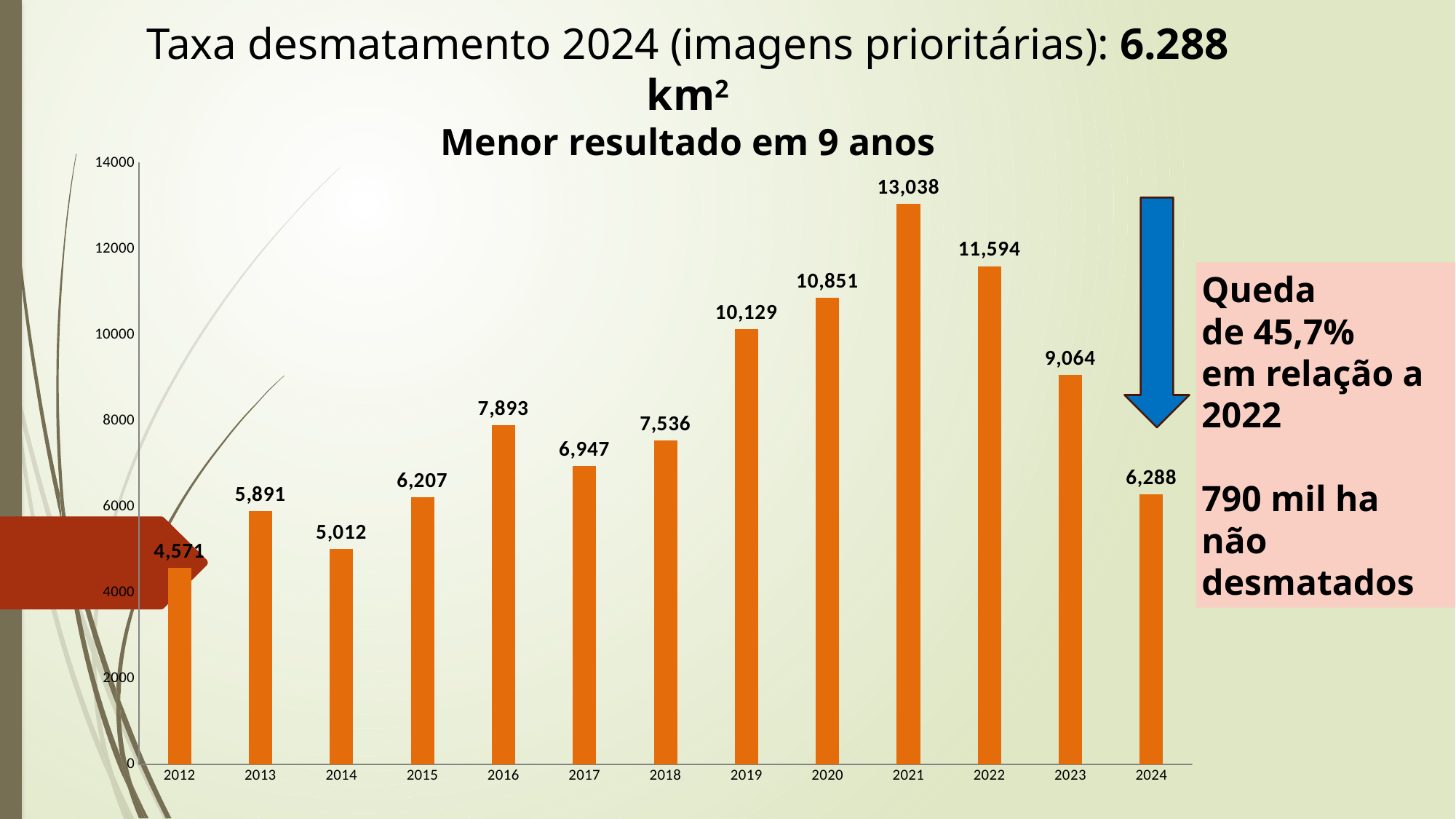
Which year has the lowest value? 2012 Which is larger, the value for 2016 or the value for 2018? 2016 What is the value for 2017? 6,947 Do the values rise or fall from 2021 to 2024? fall How many years are shown on the x axis? 13 Is the value for 2019 greater or less than 10000? greater Which year has the highest value? 2021 What kind of chart is shown on the slide? bar chart What is the value for 2024? 6,288 What is the value for 2021? 13,038 What colour are the bars in the chart? orange What is the difference between the values for 2022 and 2024? 5,306